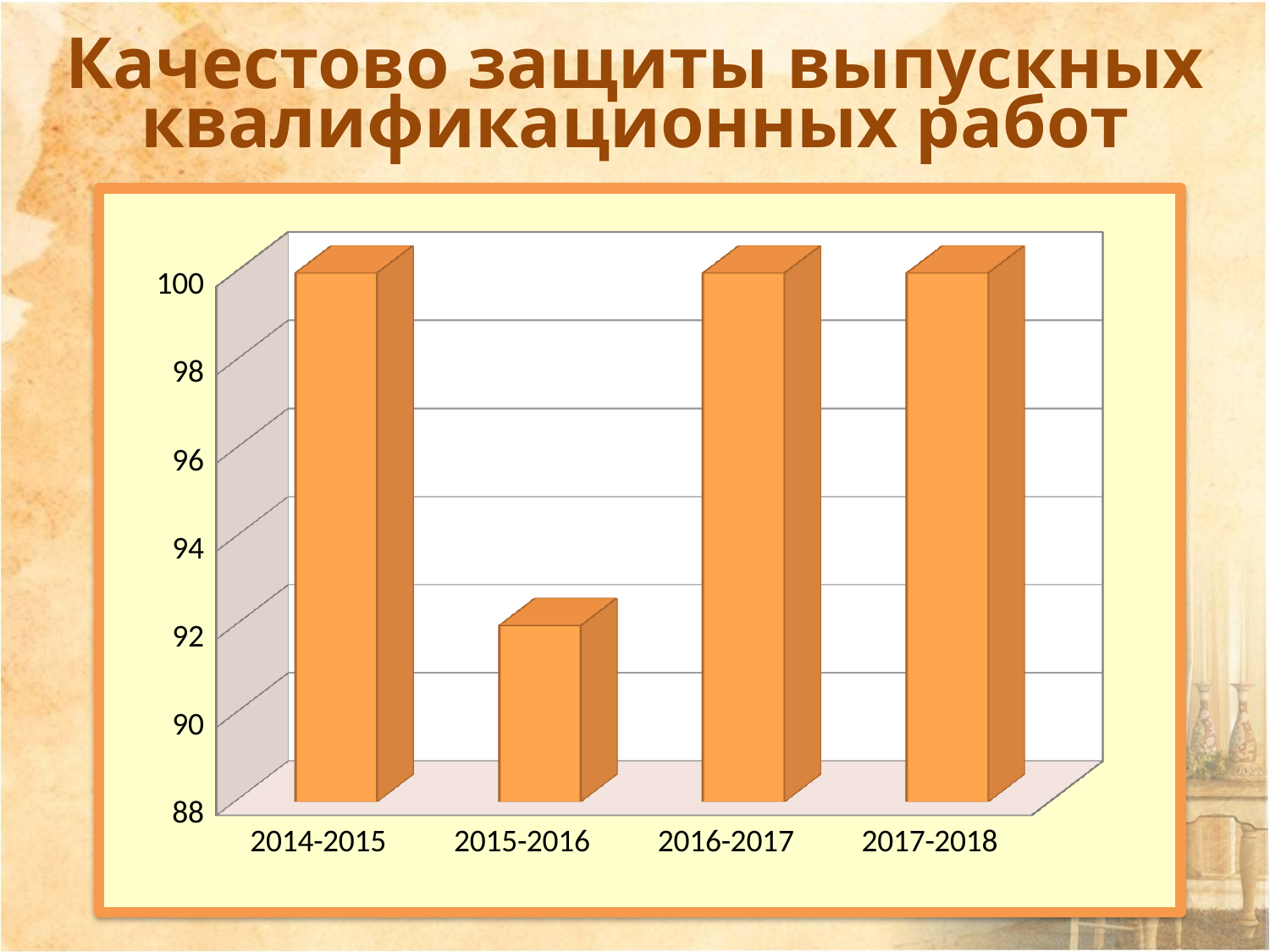
Is the value for 2017-2018 greater or less than 96? greater Which is larger, the value for 2015-2016 or the value for 2016-2017? 2016-2017 What is the title of the slide containing the chart? Качестово защиты выпускных квалификационных работ Is the value for 2015-2016 greater or less than 90? greater What kind of chart is shown on the slide? bar chart Which is larger, the value for 2014-2015 or the value for 2015-2016? 2014-2015 Which academic year has the lowest value? 2015-2016 Is the value for 2014-2015 greater or less than 98? greater Does the value rise or fall from 2015-2016 to 2016-2017? rise What colour are the bars in the chart? orange How many categories (academic years) are shown on the x axis? 4